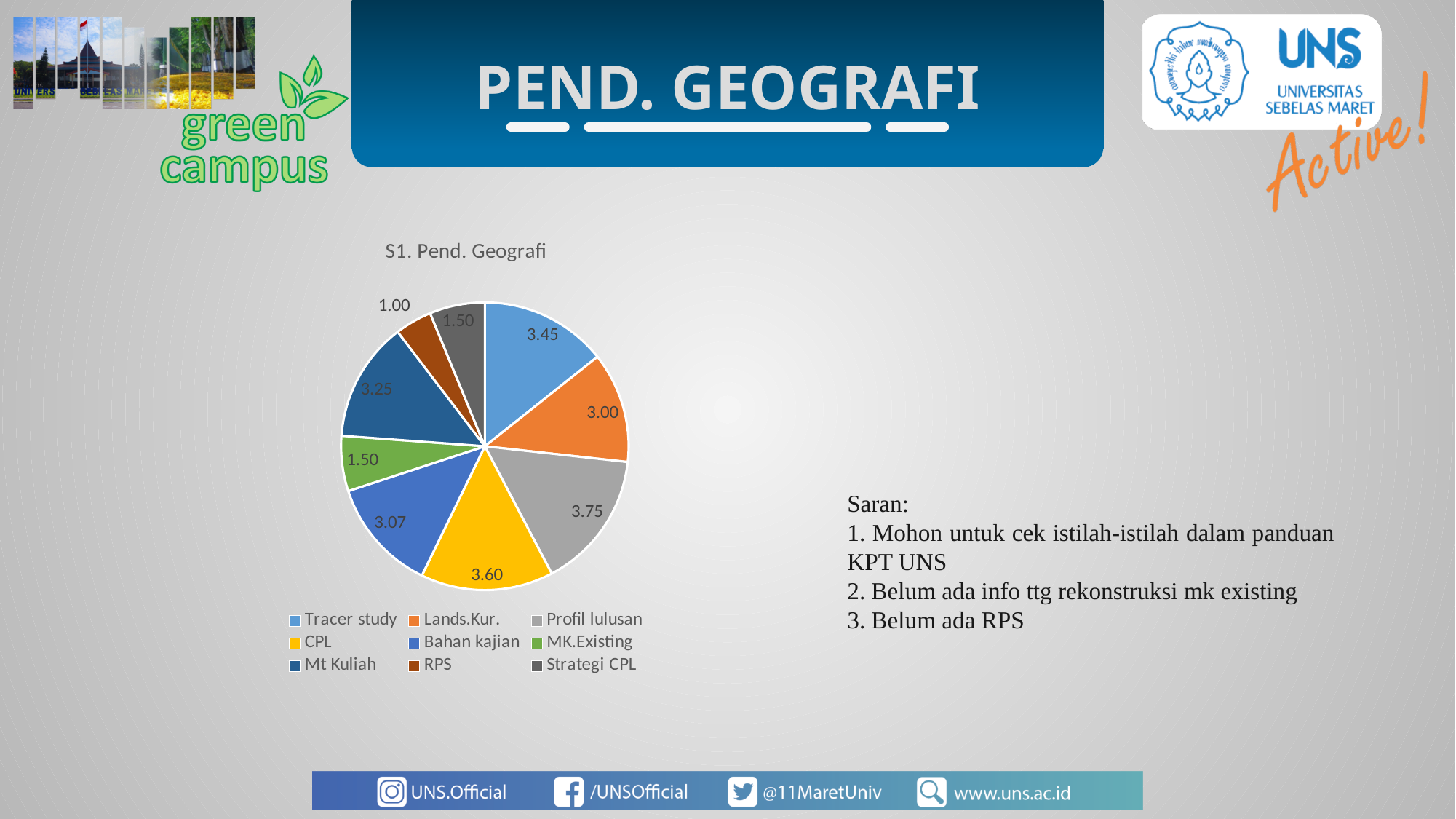
How many categories does the pie chart have? 9 What is the difference between the values for Profil lulusan and Lands.Kur.? 0.75 What is the title of the chart? S1. Pend. Geografi What is the value for RPS? 1.00 What is the value for Tracer study? 3.45 Which category has the smallest slice? RPS Which category has the largest slice? Profil lulusan Which is larger, the value for CPL or the value for Mt Kuliah? CPL What type of chart is shown on the slide? Pie chart Which colour represents MK.Existing in the legend? Green What is the value for Bahan kajian? 3.07 What is the value for Profil lulusan? 3.75